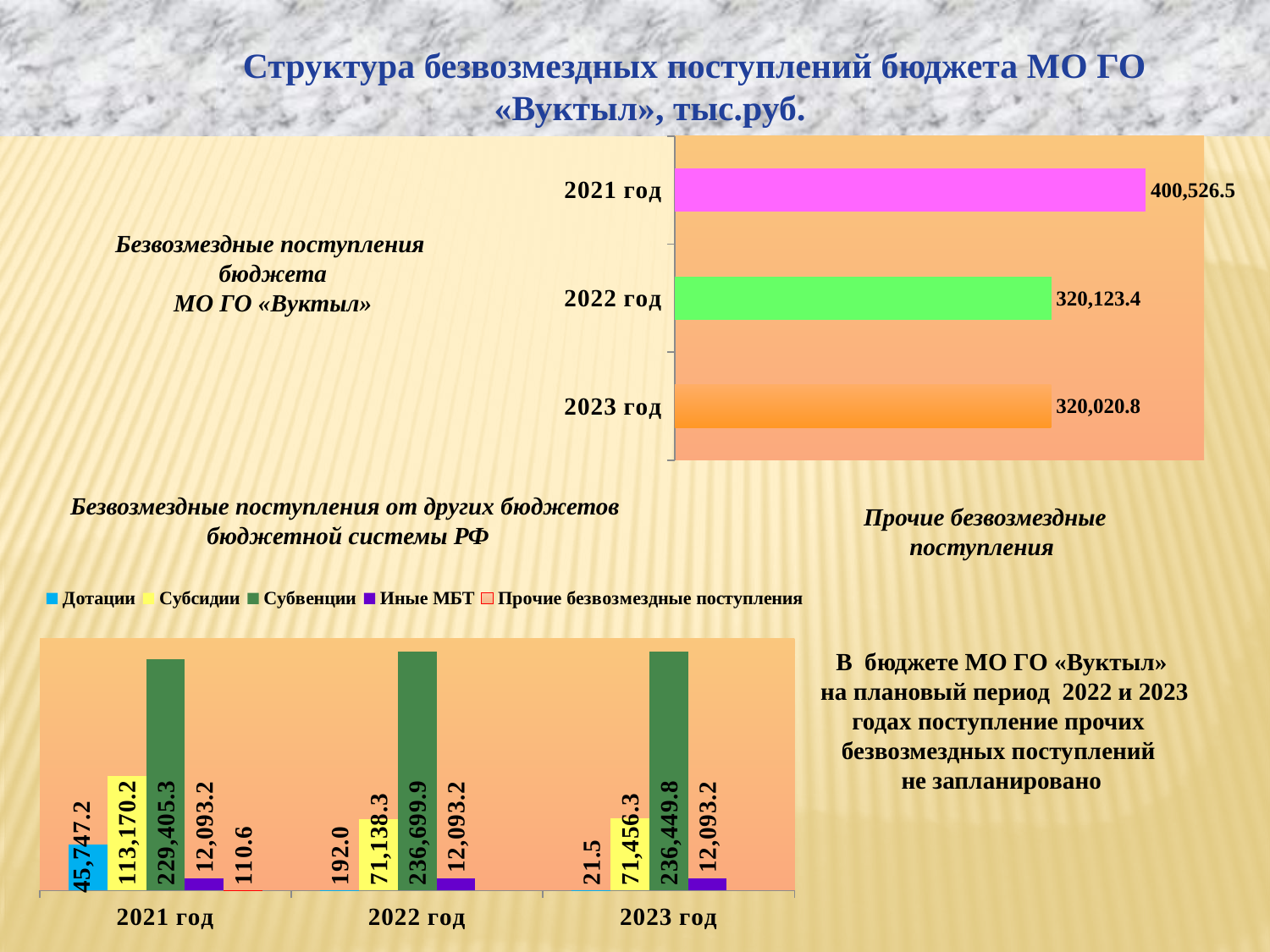
In the bottom chart, what is the value of Субвенции for 2022 год? 236,699.9 In the bottom chart, what is the value of Дотации for 2021 год? 45,747.2 In the top chart, what is the value for 2023 год? 320,020.8 In the top chart, which year has the highest value? 2021 год In the bottom chart, how many series does the legend list? 5 In the top chart (Безвозмездные поступления бюджета МО ГО «Вуктыл»), what is the value for 2021 год? 400,526.5 In the bottom chart, which is larger: Субсидии in 2022 год or Субсидии in 2023 год? Субсидии in 2023 год In the bottom chart, which series has the highest value in 2023 год? Субвенции In the top chart, what is the difference between the values for 2021 год and 2022 год? 80,403.1 What kind of chart is the top chart? bar chart In the bottom chart, what is the difference between Субсидии in 2021 год and Субсидии in 2022 год? 42,031.9 In the top chart, do the values rise or fall from 2021 год to 2023 год? fall